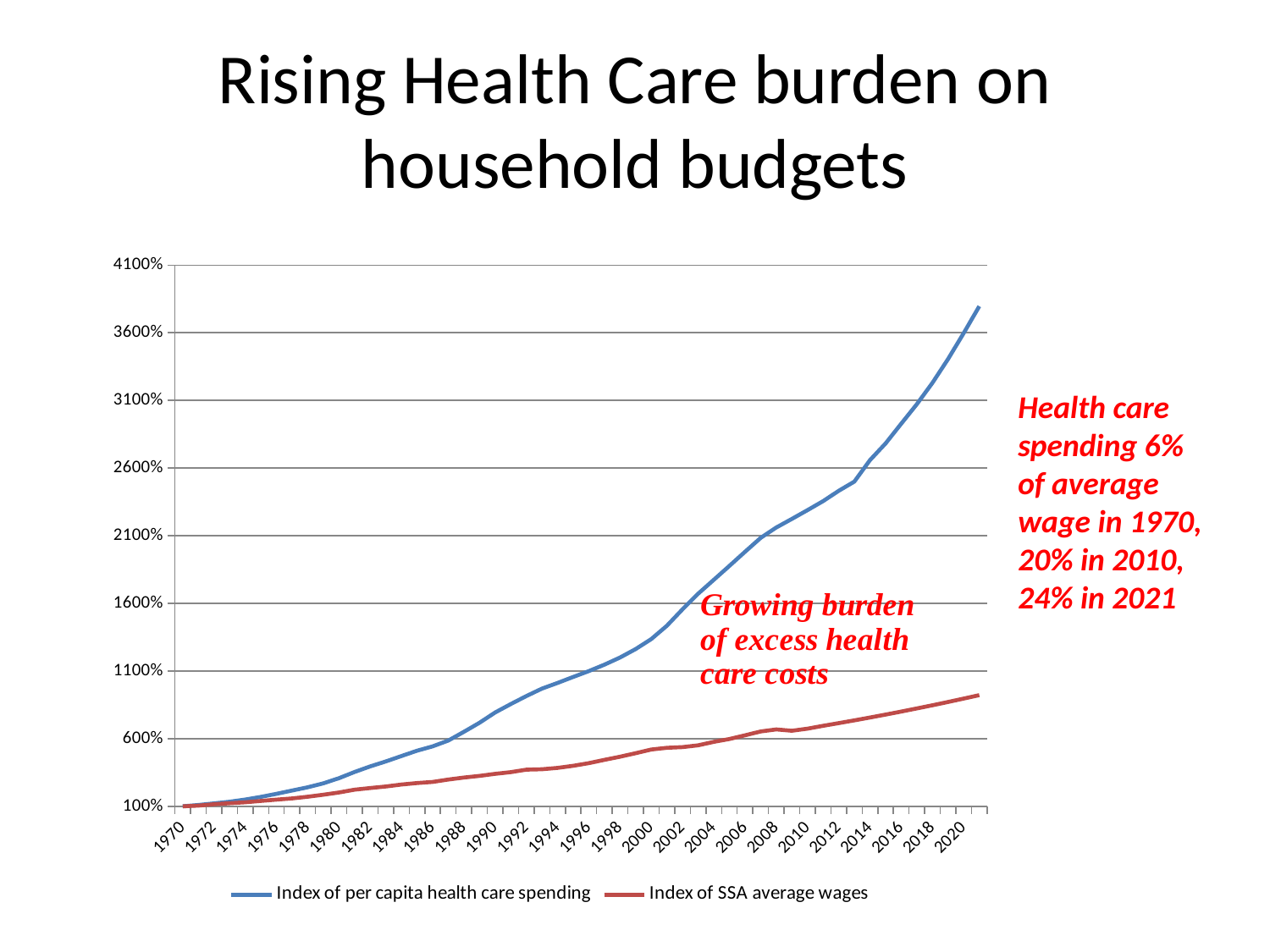
What colour is the line for the Index of SSA average wages? red What is the value of both indexes in 1970, the first year on the x axis? 100% What are the two series named in the chart legend? Index of per capita health care spending; Index of SSA average wages Does the Index of per capita health care spending rise or fall from 1970 to 2020? rise Is the value of the Index of per capita health care spending in 2020 greater or less than 3100%? greater Which series is higher in 2020: the Index of per capita health care spending or the Index of SSA average wages? Index of per capita health care spending How many year labels are shown along the x axis? 26 Is the value of the Index of SSA average wages in 2000 greater or less than 600%? less Is the value of the Index of per capita health care spending in 2000 greater or less than 1100%? greater How many series does the chart legend list? 2 What kind of chart is shown on the slide? line chart